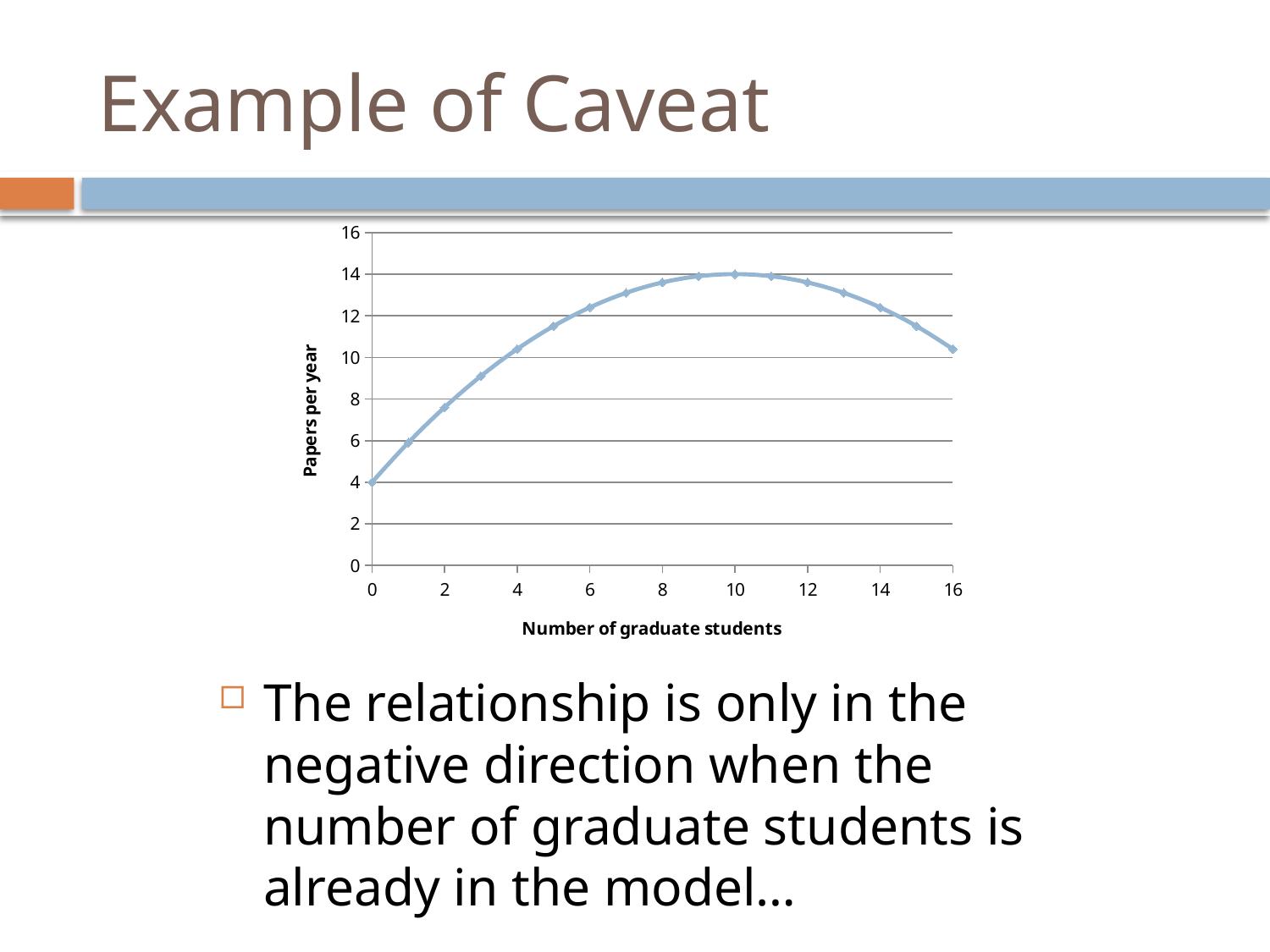
What is the value of papers per year when the number of graduate students is 0? 4 At what number of graduate students does papers per year reach its highest value? 10 How many data points are plotted on the line? 17 What kind of chart is shown on the slide? line chart Is the value for 8 graduate students greater or less than 12? greater Is the value for 2 graduate students greater or less than 6? greater What is the title of the x axis? Number of graduate students What is the title of the y axis? Papers per year Do the values rise or fall as the number of graduate students increases from 10 to 16? fall Which has a higher value of papers per year: 4 graduate students or 10 graduate students? 10 graduate students Is the value for 16 graduate students greater or less than 12? less At what number of graduate students is papers per year lowest? 0